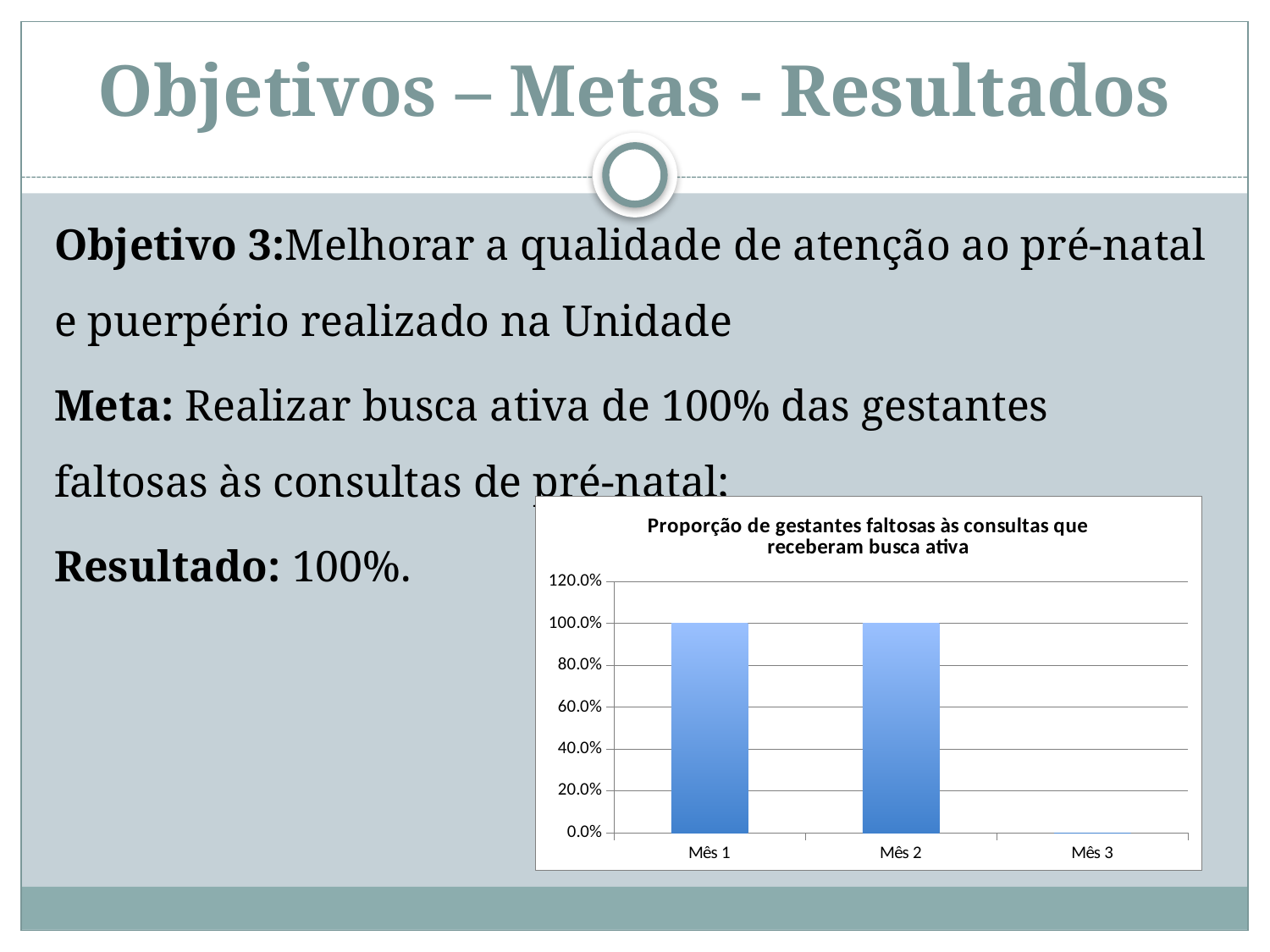
What is the label of the first category on the x axis of the chart? Mês 1 What is the value for Mês 2 in the chart? 100.0% Do the values rise or fall from Mês 2 to Mês 3? fall What is the title of the chart? Proporção de gestantes faltosas às consultas que receberam busca ativa Which is larger, the value for Mês 2 or the value for Mês 3? Mês 2 Is the value for Mês 3 greater or less than 20.0%? less What kind of chart is shown on the slide? bar chart Which category has the lowest value in the chart? Mês 3 Is the value for Mês 1 greater or less than 80.0%? greater How many categories are shown on the x axis of the chart? 3 What is the value for Mês 1 in the chart? 100.0% Which is larger, the value for Mês 1 or the value for Mês 3? Mês 1